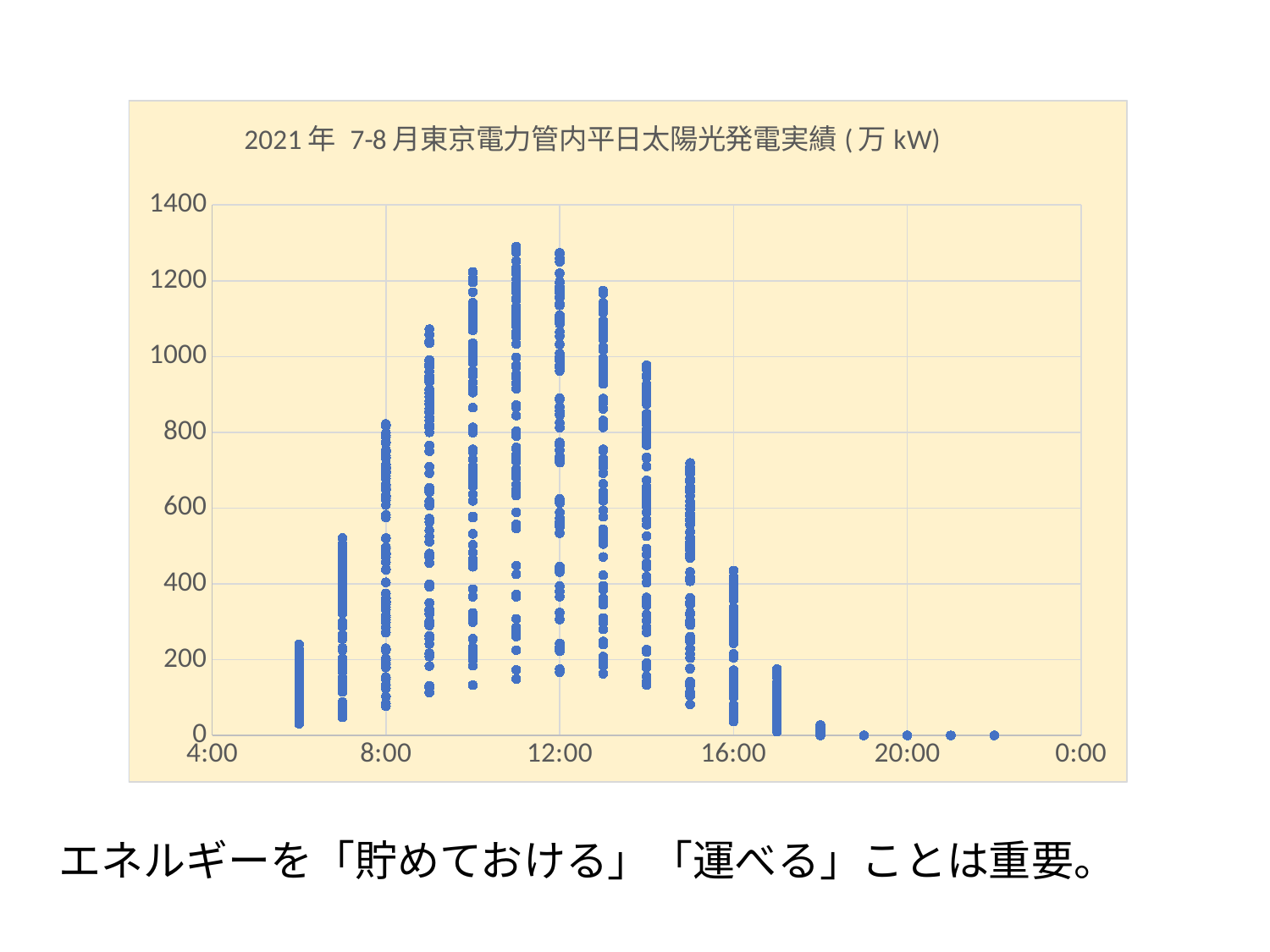
Which hour has higher maximum values, 9:00 or 15:00? 9:00 Do the values at 20:00 lie above or at 0? at 0 Which hour has higher maximum values, 11:00 or 14:00? 11:00 Are the highest points at 13:00 greater or less than 1000? greater Are the highest points at 16:00 greater or less than 600? less How do the values change along the x axis from 4:00 to 0:00? They rise to a peak around midday and then fall What is the title of the chart? 2021年 7-8月東京電力管内平日太陽光発電実績(万kW) What is the highest value shown on the y axis? 1400 What kind of chart is shown on the slide? scatter chart